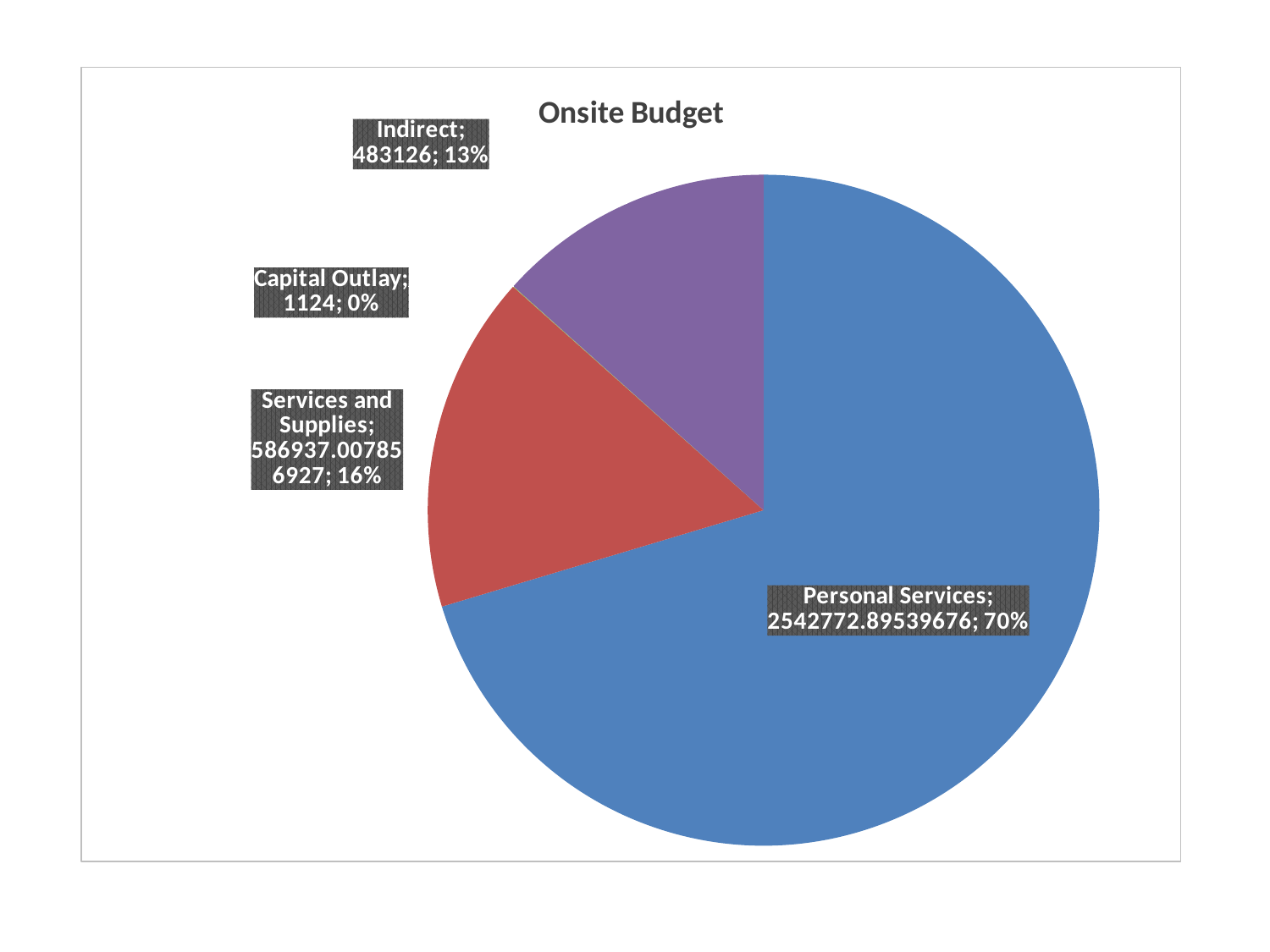
Which category has the smallest slice? Capital Outlay What is the value for Personal Services? 2542772.89539676 What share of the pie does Personal Services represent? 70% Which is larger, Services and Supplies or Indirect? Services and Supplies Which category has the largest slice? Personal Services How many slices does the pie chart have? 4 What is the difference between the values for Indirect and Capital Outlay? 482002 What type of chart is shown on the slide? Pie chart What is the title of the chart? Onsite Budget What is the value for Indirect? 483126 What share of the pie does Services and Supplies represent? 16% What is the value for Capital Outlay? 1124